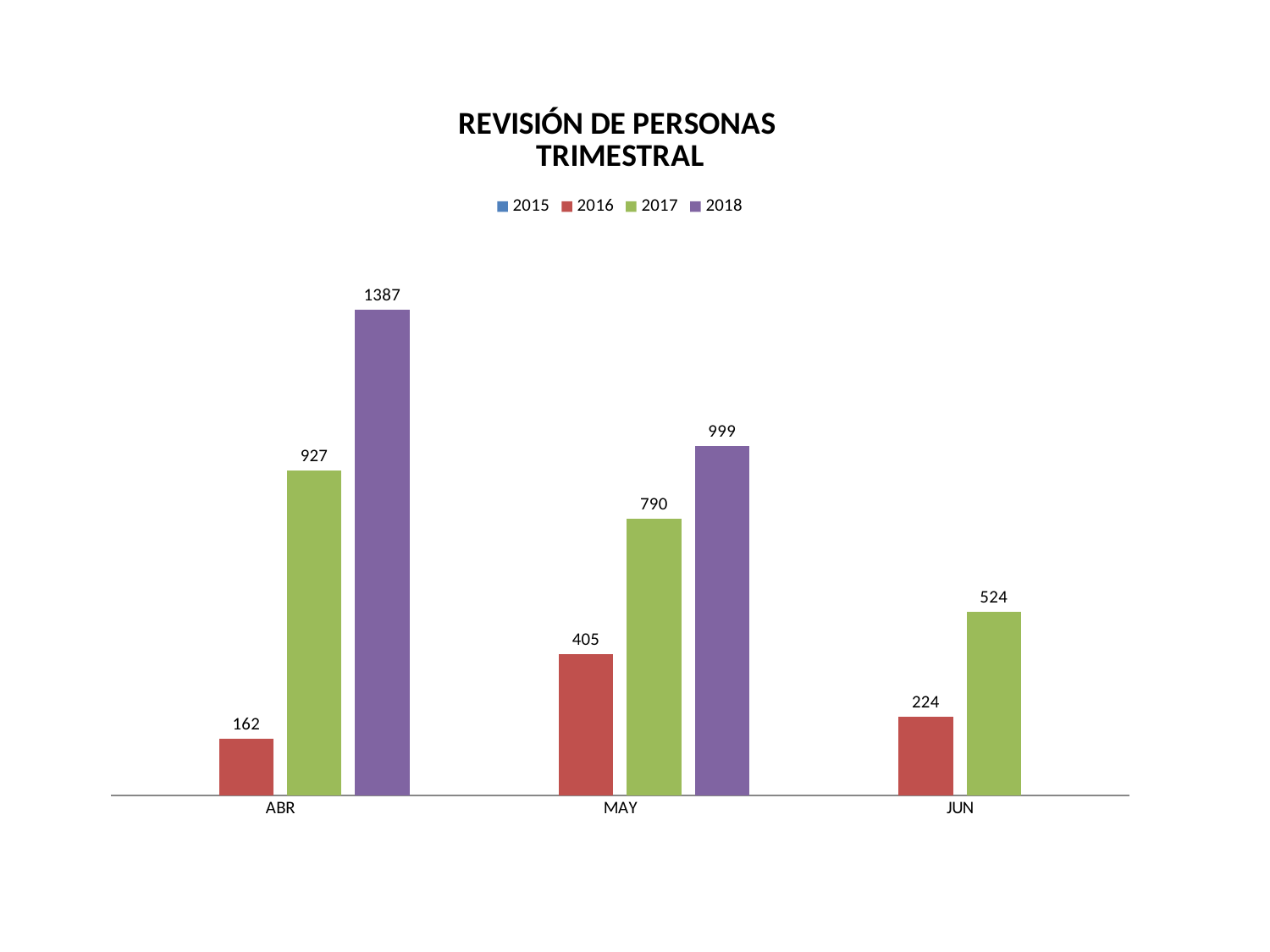
Which month has the lowest value for 2016? ABR Which is larger, the 2016 value in MAY or the 2016 value in JUN? 2016 value in MAY How many months are shown on the x axis? 3 What is the value for 2016 in JUN? 224 What is the value for 2017 in JUN? 524 What is the title of the chart? REVISIÓN DE PERSONAS TRIMESTRAL What kind of chart is this? Bar chart How many series does the legend list? 4 Which month has the highest value for 2018? ABR What is the value for 2018 in ABR? 1387 What is the value for 2017 in MAY? 790 What is the difference between the 2018 and 2017 values in ABR? 460